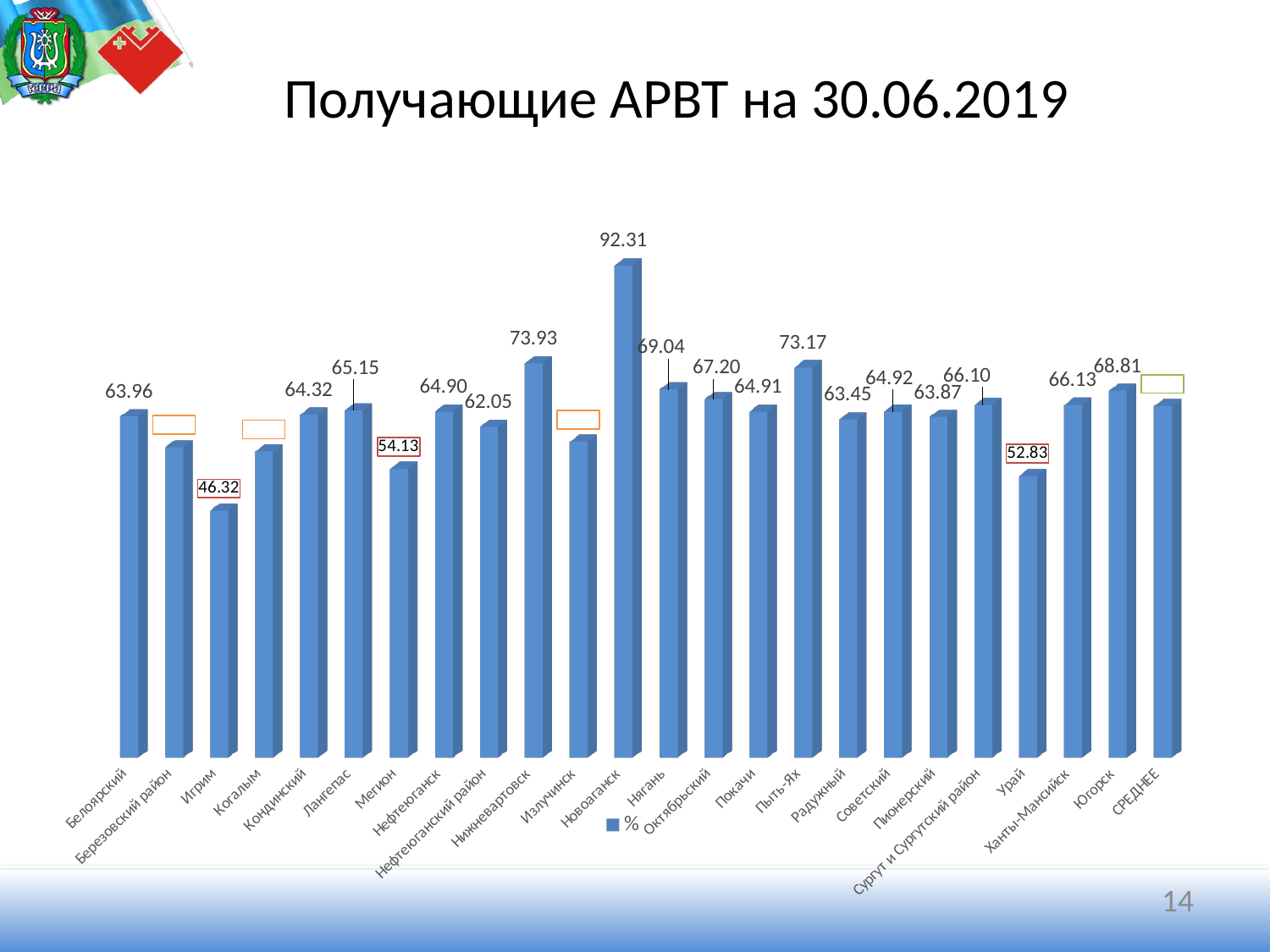
Which is larger, the value for Нягань or the value for Урай? Нягань What is the value for Урай? 52.83 How many categories are shown on the x axis? 24 What is the title of the chart? Получающие АРВТ на 30.06.2019 What kind of chart is shown on the slide? bar chart Which category has the highest value? Новоаганск What is the value for Нижневартовск? 73.93 What is the value for Игрим? 46.32 What is the value for Новоаганск? 92.31 What is the difference between the values for Новоаганск and Игрим? 45.99 Which category has the lowest value? Игрим How many series does the legend list? 1